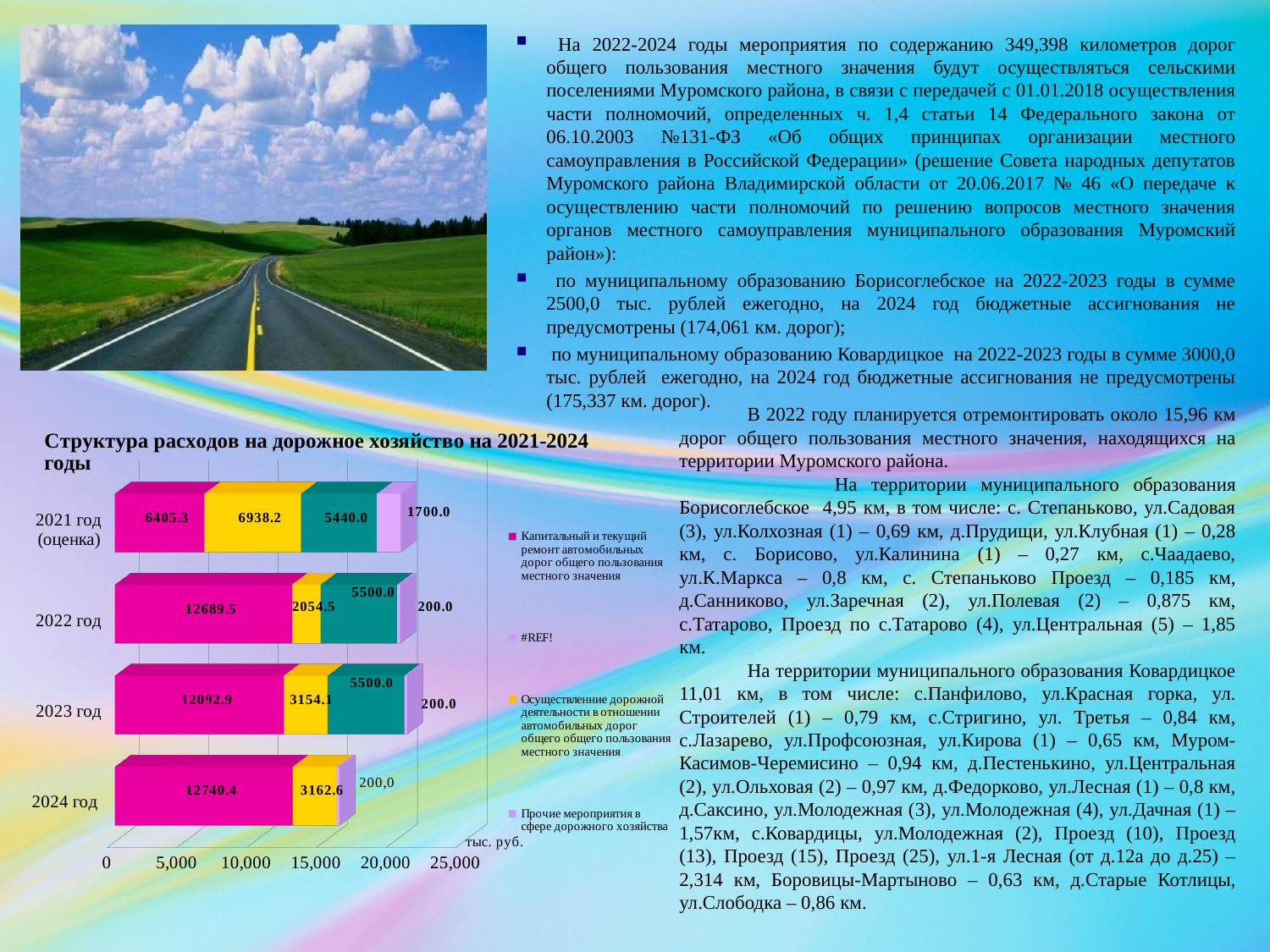
What is the total of the stacked bar for 2021 год (оценка)? 20483.5 How many year categories are plotted on the chart? 4 In 2021 год (оценка), what is the difference between the 'Осуществление дорожной деятельности' value (6938.2) and the 'Капитальный и текущий ремонт' value (6405.3)? 532.9 What kind of chart is shown on the slide? Bar chart What is the value for 'Прочие мероприятия в сфере дорожного хозяйства' in 2021 год (оценка)? 1700.0 Which year has the lowest value for 'Капитальный и текущий ремонт автомобильных дорог общего пользования местного значения'? 2021 год (оценка) What is the value for 'Капитальный и текущий ремонт автомобильных дорог общего пользования местного значения' in 2022 год? 12689.5 Which year has the highest value for 'Капитальный и текущий ремонт автомобильных дорог общего пользования местного значения'? 2024 год What is the value for 'Осуществление дорожной деятельности в отношении автомобильных дорог общего пользования местного значения' in 2023 год? 3154.1 How many series does the chart legend list? 4 Which year has the larger value for 'Осуществление дорожной деятельности в отношении автомобильных дорог общего пользования местного значения': 2022 год or 2023 год? 2023 год What is the title of the chart? Структура расходов на дорожное хозяйство на 2021-2024 годы